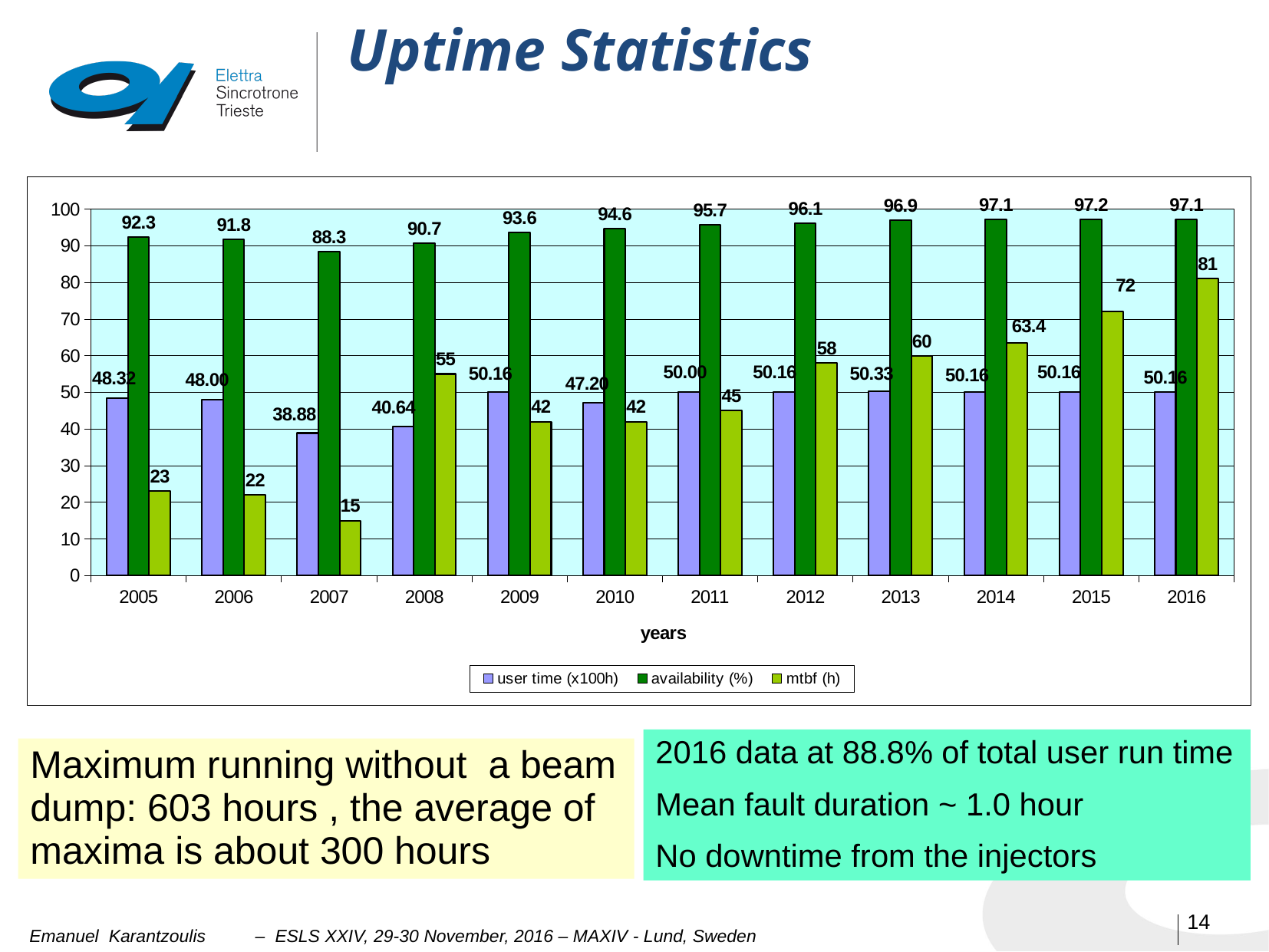
Which year has the lowest user time (x100h)? 2007 What is the difference between the mtbf (h) values for 2016 and 2015? 9 Which is larger, the availability (%) for 2009 or for 2008? 2009 What is the user time (x100h) value for 2007? 38.88 What is the availability (%) value for 2013? 96.9 Is the mtbf (h) value for 2014 greater or less than 60? greater Which year has the highest availability (%)? 2015 What kind of chart is shown on the slide? bar chart How many series does the legend list? 3 What is the mtbf (h) value for 2008? 55 How many years are shown on the x axis? 12 Which year has the lowest mtbf (h)? 2007